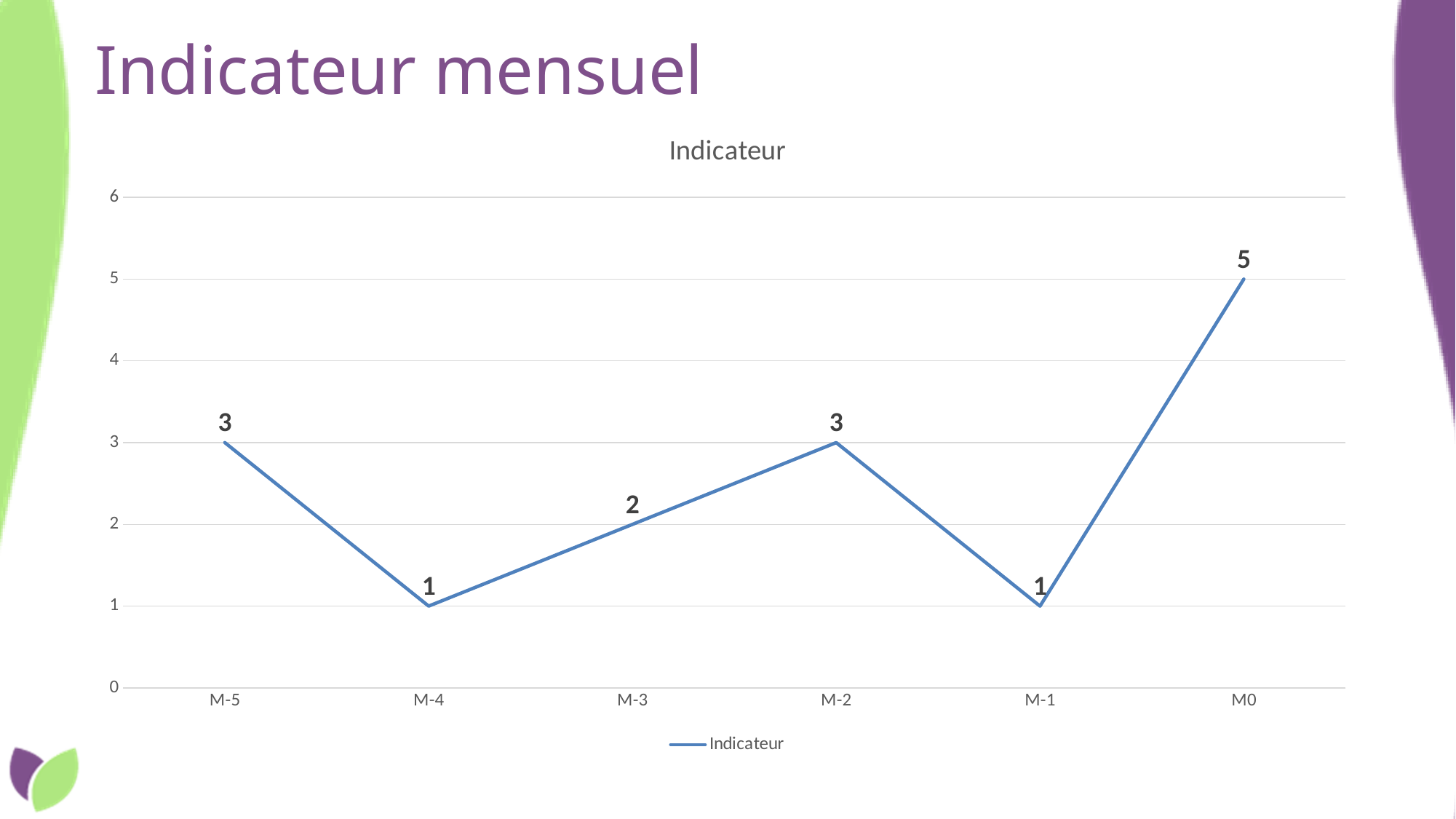
What is the difference between the Indicateur values at M-2 and M-3? 1 What kind of chart is shown on the slide? line chart Which month has the highest Indicateur value? M0 Which is larger, the Indicateur value at M-5 or at M-4? M-5 What is the value of Indicateur at M-5? 3 What is the title of the chart? Indicateur What is the value of Indicateur at M-3? 2 What is the value of Indicateur at M0? 5 How many months are shown on the x axis? 6 Is the value for M0 greater or less than 4? greater How many series does the legend list? 1 What is the difference between the Indicateur values at M0 and M-1? 4